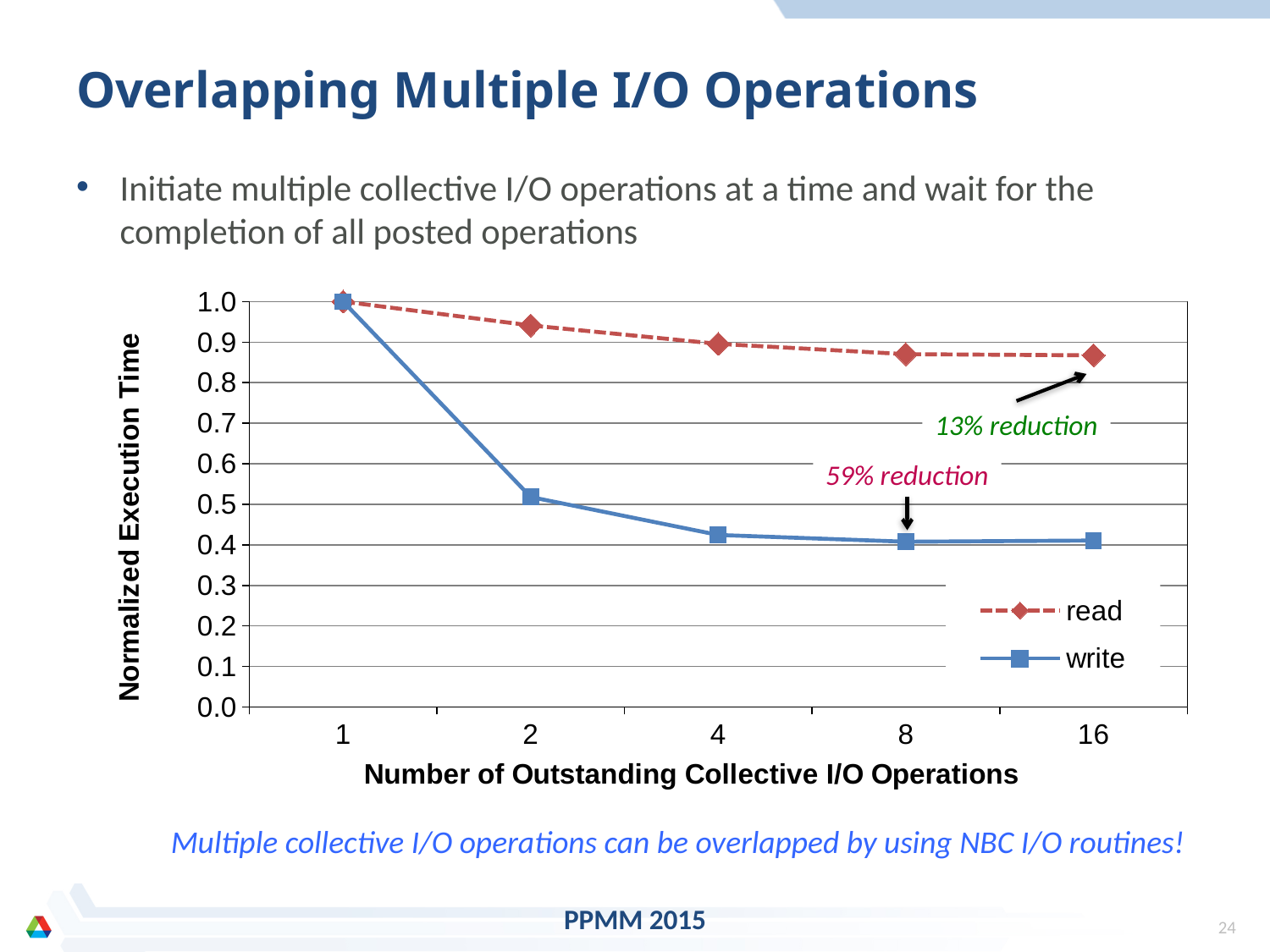
What percentage reduction is annotated for the write series? 59% reduction What kind of chart is shown on the slide? line chart What is the normalized execution time for read at 1 outstanding collective I/O operation? 1.0 How many points are plotted along the x axis for each series? 5 What is the normalized execution time for write at 1 outstanding collective I/O operation? 1.0 Is the value for read at 2 outstanding operations greater or less than 0.9? greater What is the title of the y axis? Normalized Execution Time Does the write series rise or fall as the number of outstanding collective I/O operations increases? fall Is the value for write at 4 outstanding operations greater or less than 0.5? less Is the value for read at 16 outstanding operations greater or less than 0.9? less At 8 outstanding collective I/O operations, which series has the higher normalized execution time, read or write? read How many series does the legend list? 2